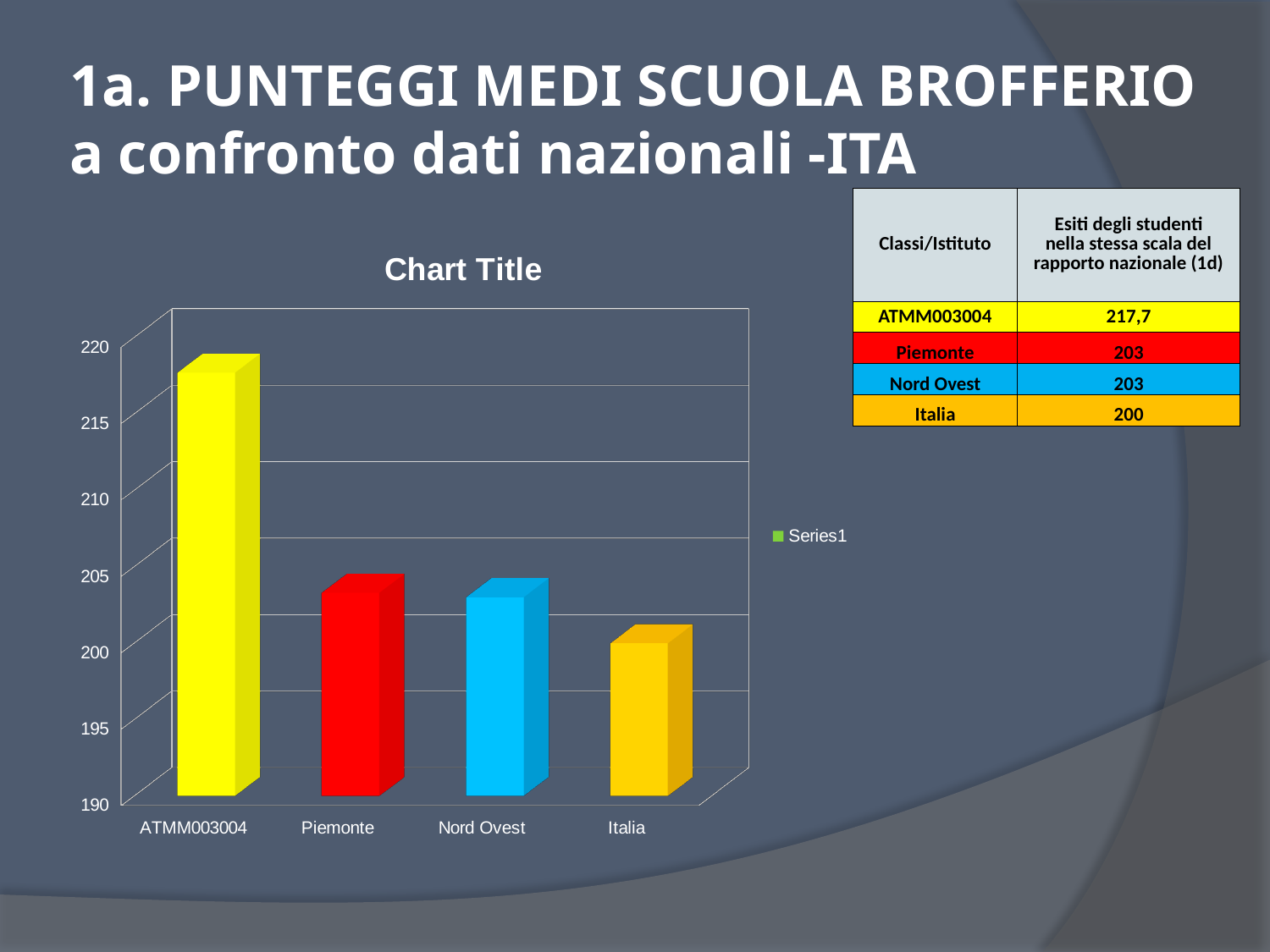
How many series does the chart legend list? 1 What is the difference between the values for ATMM003004 and Italia? 17,7 Which category has the highest bar in the chart? ATMM003004 What is the value for Piemonte shown in the table next to the chart? 203 How many categories are shown on the x axis of the chart? 4 Which category has the lowest bar in the chart? Italia Is the value for Nord Ovest greater or less than 205? less What is the value for Italia shown in the table next to the chart? 200 What kind of chart is shown on the slide? Bar chart What is the value for ATMM003004 shown in the table next to the chart? 217,7 Is the value for ATMM003004 greater or less than 215? greater Which is larger, the value for ATMM003004 or the value for Piemonte? ATMM003004